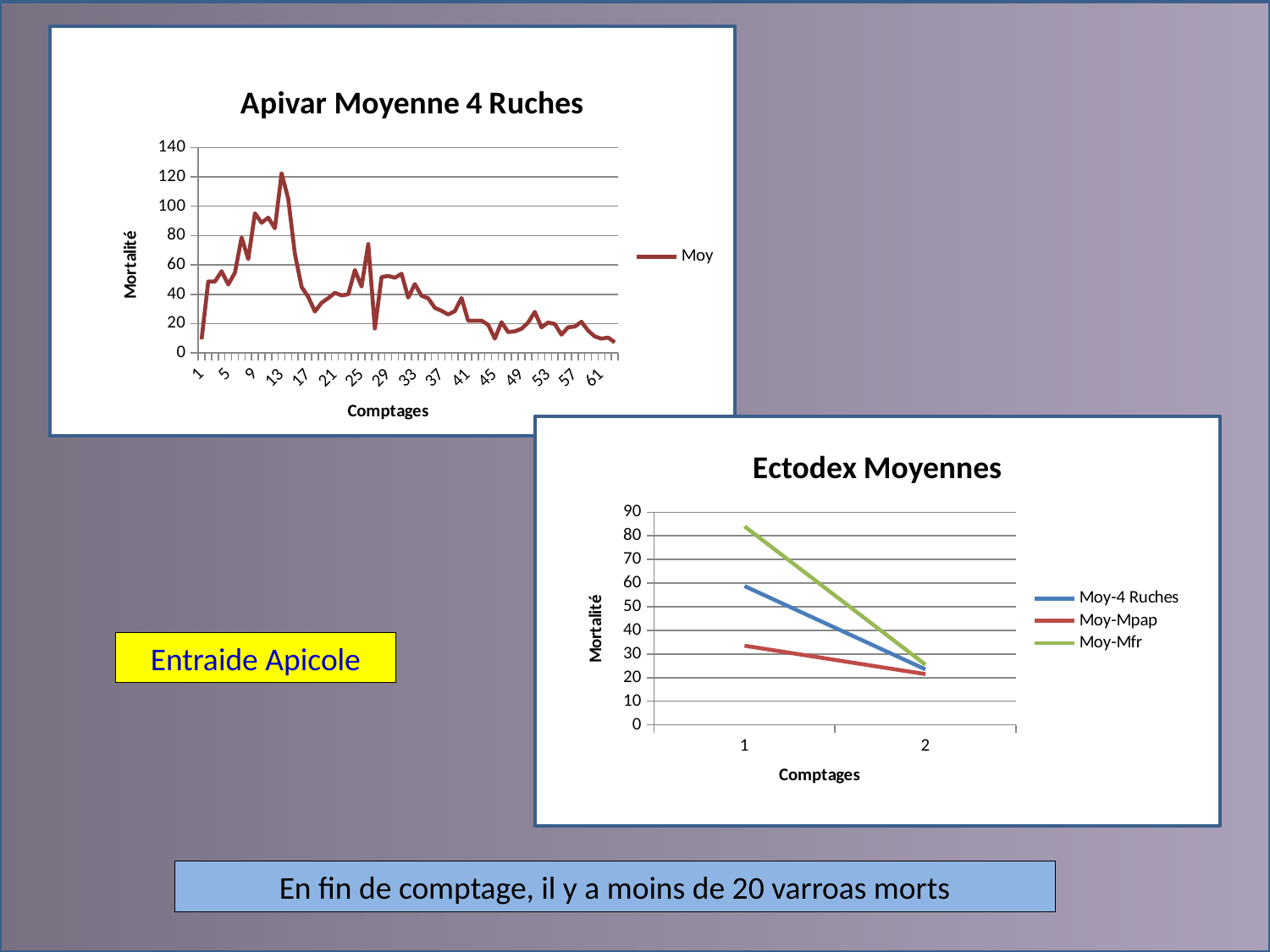
In the "Apivar Moyenne 4 Ruches" chart, do the values of the Moy series overall rise or fall from comptage 13 to comptage 61? fall In the "Ectodex Moyennes" chart, is the value of Moy-Mfr at comptage 1 greater or less than 80? greater How many series does the legend of the "Ectodex Moyennes" chart list? 3 What kind of chart is the "Apivar Moyenne 4 Ruches" chart? line chart What is the y-axis label of the "Apivar Moyenne 4 Ruches" chart? Mortalité In the "Apivar Moyenne 4 Ruches" chart, what is the name of the series shown in the legend? Moy In the "Apivar Moyenne 4 Ruches" chart, is the peak value of the Moy series greater or less than 100? greater In the "Ectodex Moyennes" chart, which series has the lowest value at comptage 1? Moy-Mpap In the "Ectodex Moyennes" chart, which series has the highest value at comptage 1? Moy-Mfr In the "Ectodex Moyennes" chart, do the values of Moy-4 Ruches rise or fall from comptage 1 to comptage 2? fall How many series does the legend of the "Apivar Moyenne 4 Ruches" chart list? 1 What kind of chart is the "Ectodex Moyennes" chart? line chart